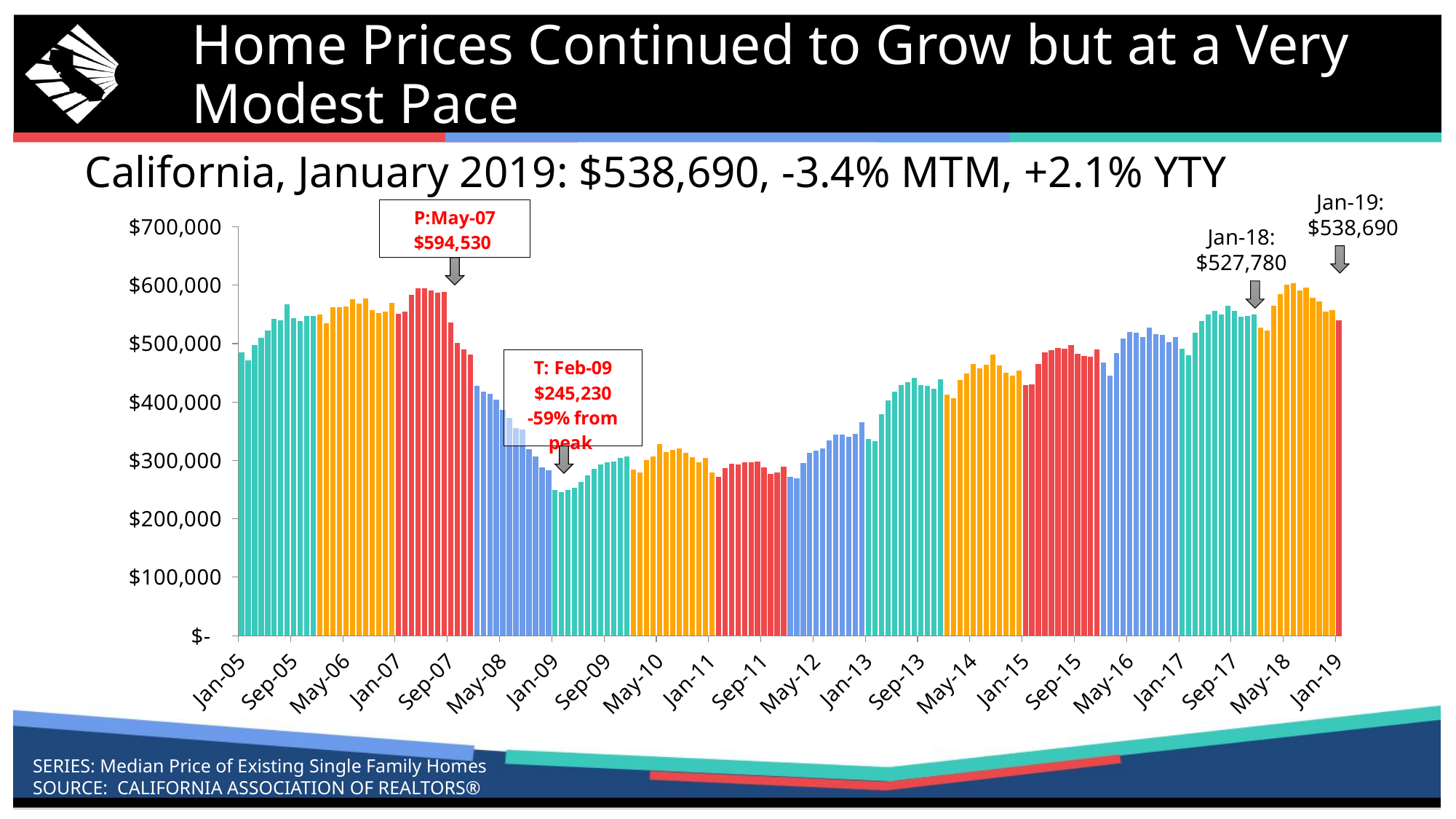
What was the median price at the peak in May-07? $594,530 What was the median price in Jan-18? $527,780 What was the median price in Jan-19? $538,690 What kind of chart is shown on the slide? bar chart Which month is marked as the peak of the series? May-07 Which month is marked as the trough of the series? Feb-09 What was the median price at the trough in Feb-09? $245,230 By what percentage did the median price fall from the peak to the trough, according to the annotation? -59% How much higher is the Jan-19 median price than the Jan-18 median price? $10,910 Which is larger, the median price in Jan-18 or in Jan-19? Jan-19 What is the difference between the peak (May-07) and trough (Feb-09) median prices? $349,300 Is the value for Jan-05 greater or less than $400,000? greater